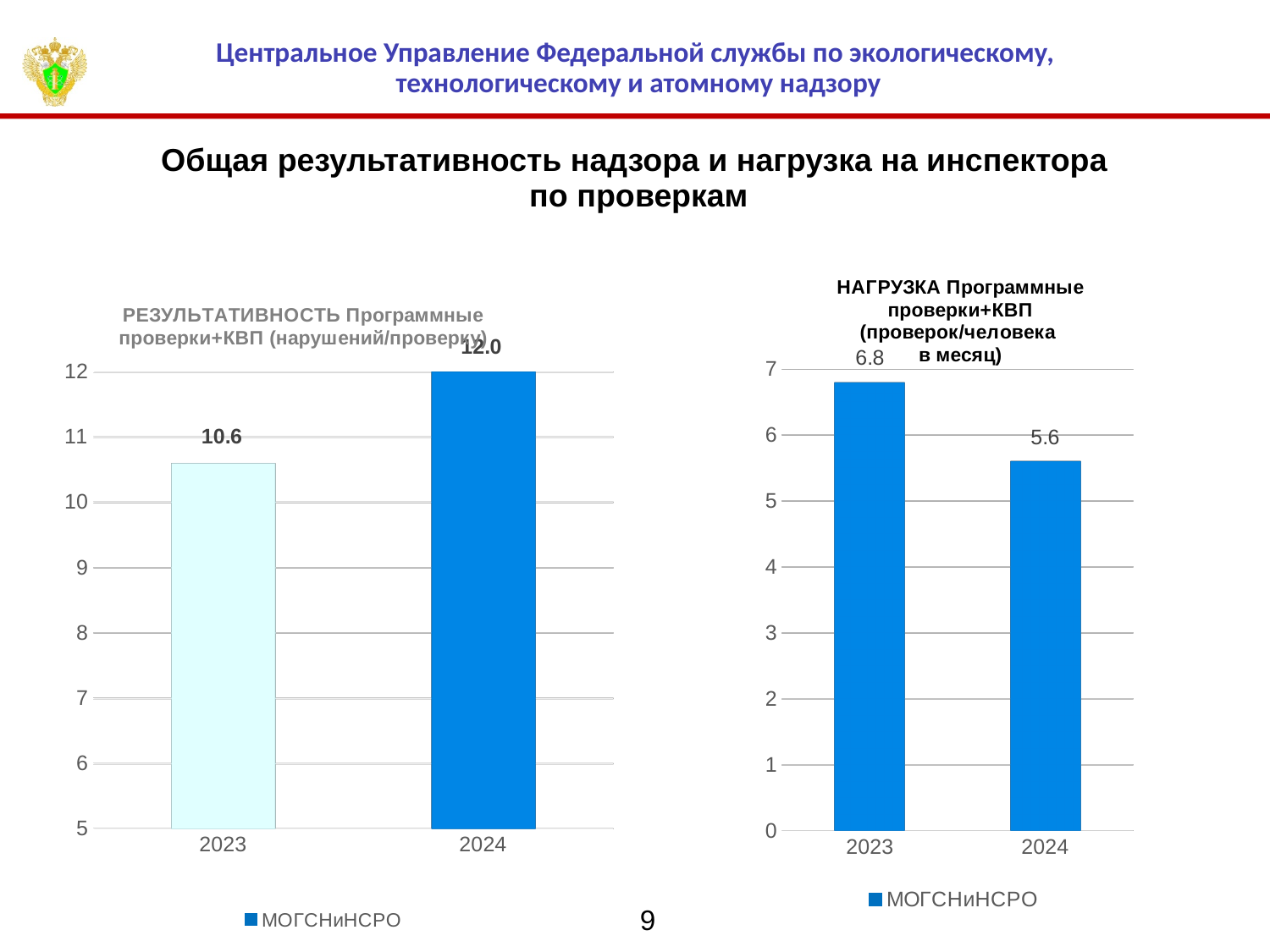
In the left chart (РЕЗУЛЬТАТИВНОСТЬ), what is the difference between the 2024 and 2023 values? 1.4 In the left chart (РЕЗУЛЬТАТИВНОСТЬ), what is the value for 2024? 12.0 In the right chart (НАГРУЗКА), which year has the lower value? 2024 In the right chart (НАГРУЗКА), what is the value for 2024? 5.6 In the left chart (РЕЗУЛЬТАТИВНОСТЬ), what is the value for 2023? 10.6 In the right chart (НАГРУЗКА), what is the value for 2023? 6.8 How many series does the legend of the left chart (РЕЗУЛЬТАТИВНОСТЬ) list? 1 What type of chart is the right chart (НАГРУЗКА)? bar chart In the right chart (НАГРУЗКА), do the values rise or fall from 2023 to 2024? fall In the right chart (НАГРУЗКА), what is the difference between the 2023 and 2024 values? 1.2 In the left chart (РЕЗУЛЬТАТИВНОСТЬ), which year has the higher value? 2024 In the left chart (РЕЗУЛЬТАТИВНОСТЬ), do the values rise or fall from 2023 to 2024? rise